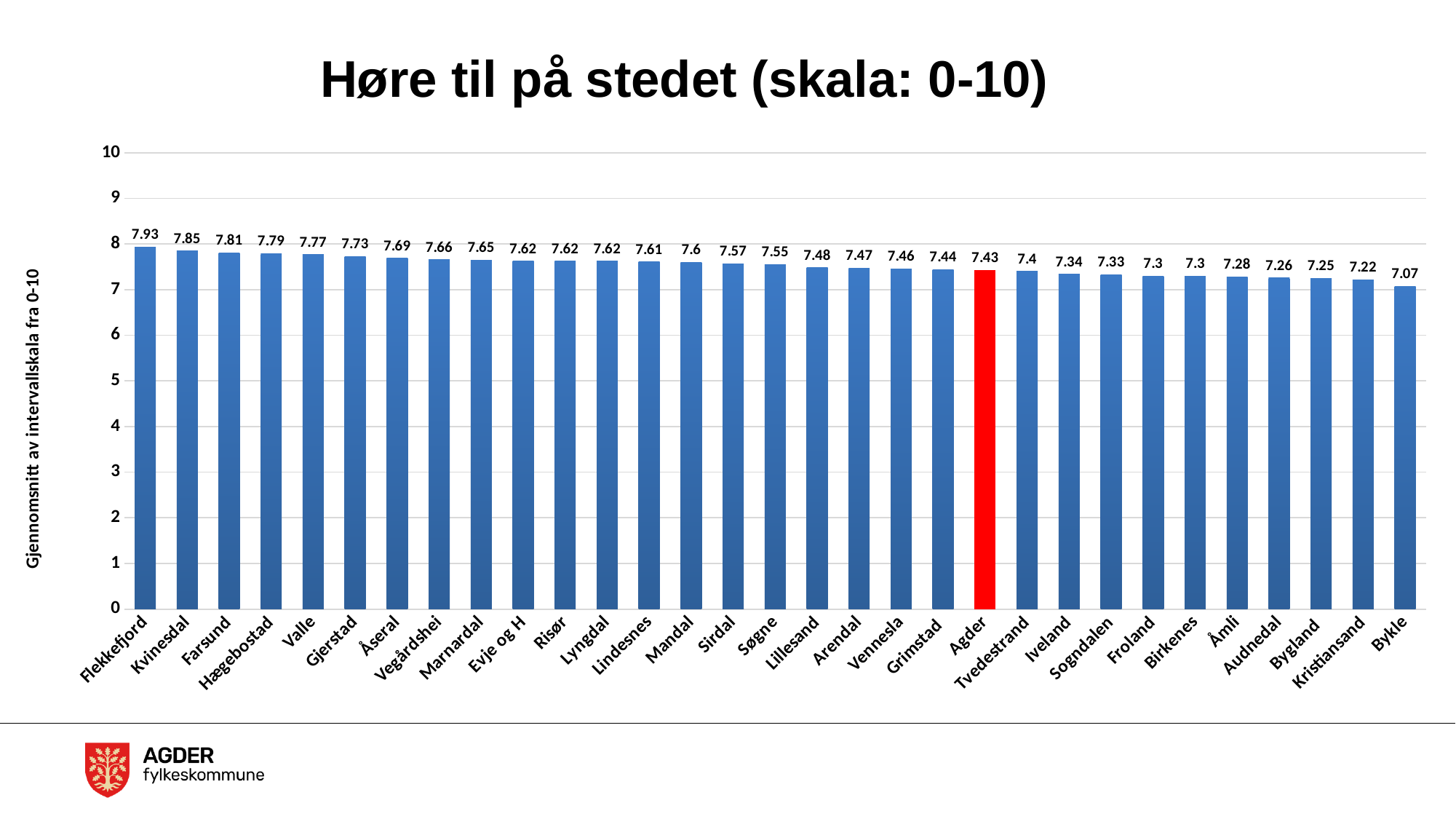
Which bar is coloured red instead of blue? Agder What is the value for Kristiansand? 7.22 Do the values rise or fall from left to right along the x axis? fall What is the value for Flekkefjord? 7.93 Which category has the lowest value? Bykle Which has a larger value, Arendal or Kristiansand? Arendal What kind of chart is shown on the slide? bar chart Is the value for Bykle greater or less than 8? less Which category has the highest value? Flekkefjord What is the value for Agder? 7.43 What is the difference between the values for Flekkefjord and Bykle? 0.86 How many categories are shown on the x axis? 31